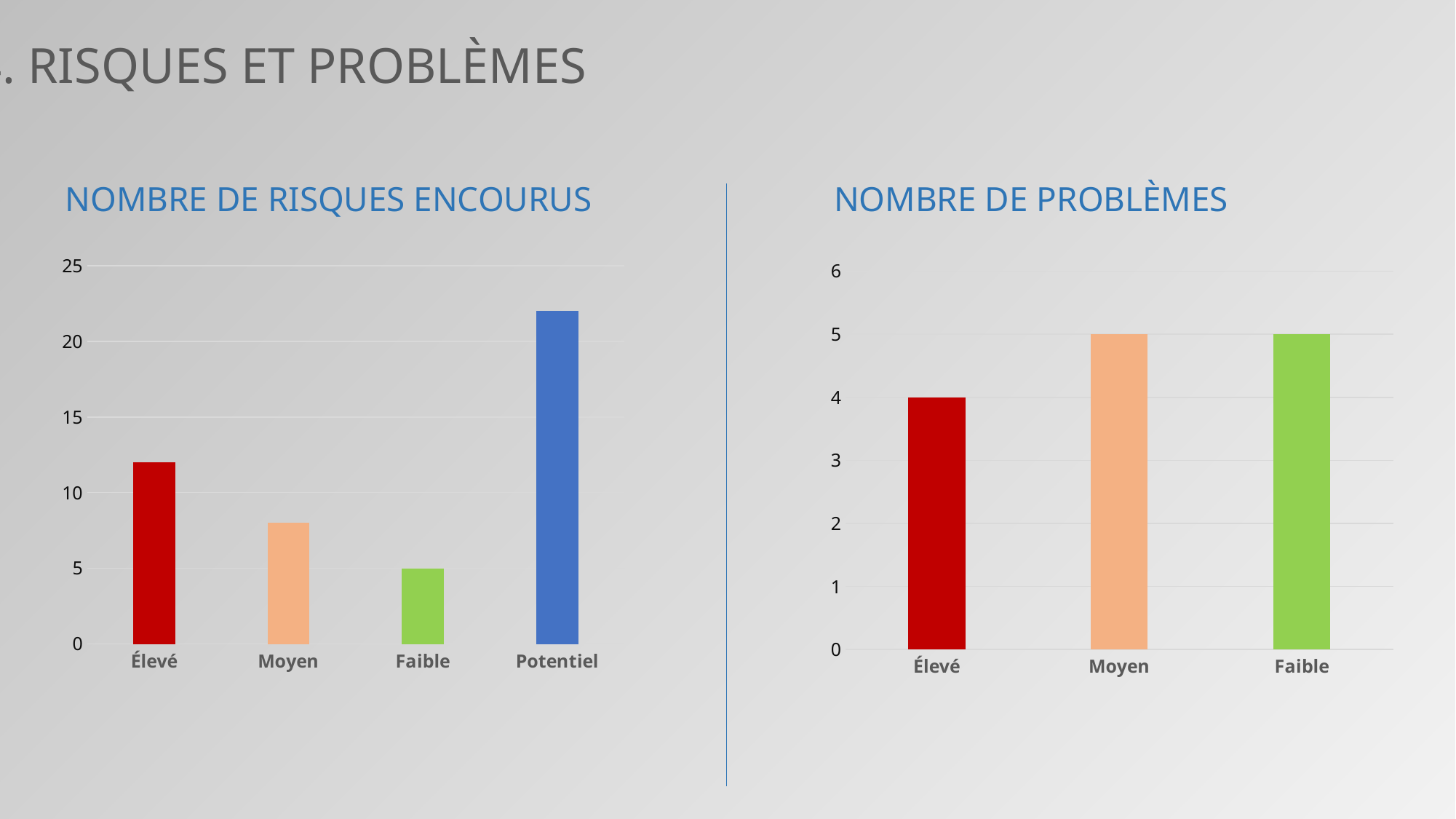
What kind of chart is the chart titled NOMBRE DE PROBLÈMES? bar chart In the chart titled NOMBRE DE PROBLÈMES, what is the difference between the values for Moyen and Élevé? 1 In the chart titled NOMBRE DE PROBLÈMES, what is the value for Élevé? 4 In the chart titled NOMBRE DE RISQUES ENCOURUS, which is larger, the value for Élevé or the value for Moyen? Élevé In the chart titled NOMBRE DE RISQUES ENCOURUS, which category has the lowest value? Faible In the chart titled NOMBRE DE RISQUES ENCOURUS, is the value for Potentiel greater or less than 20? greater In the chart titled NOMBRE DE RISQUES ENCOURUS, is the value for Moyen greater or less than 10? less In the chart titled NOMBRE DE PROBLÈMES, what is the value for Moyen? 5 In the chart titled NOMBRE DE PROBLÈMES, which category has the lowest value? Élevé In the chart titled NOMBRE DE RISQUES ENCOURUS, which category has the highest value? Potentiel In the chart titled NOMBRE DE RISQUES ENCOURUS, what is the value for Faible? 5 How many categories are shown in the chart titled NOMBRE DE RISQUES ENCOURUS? 4